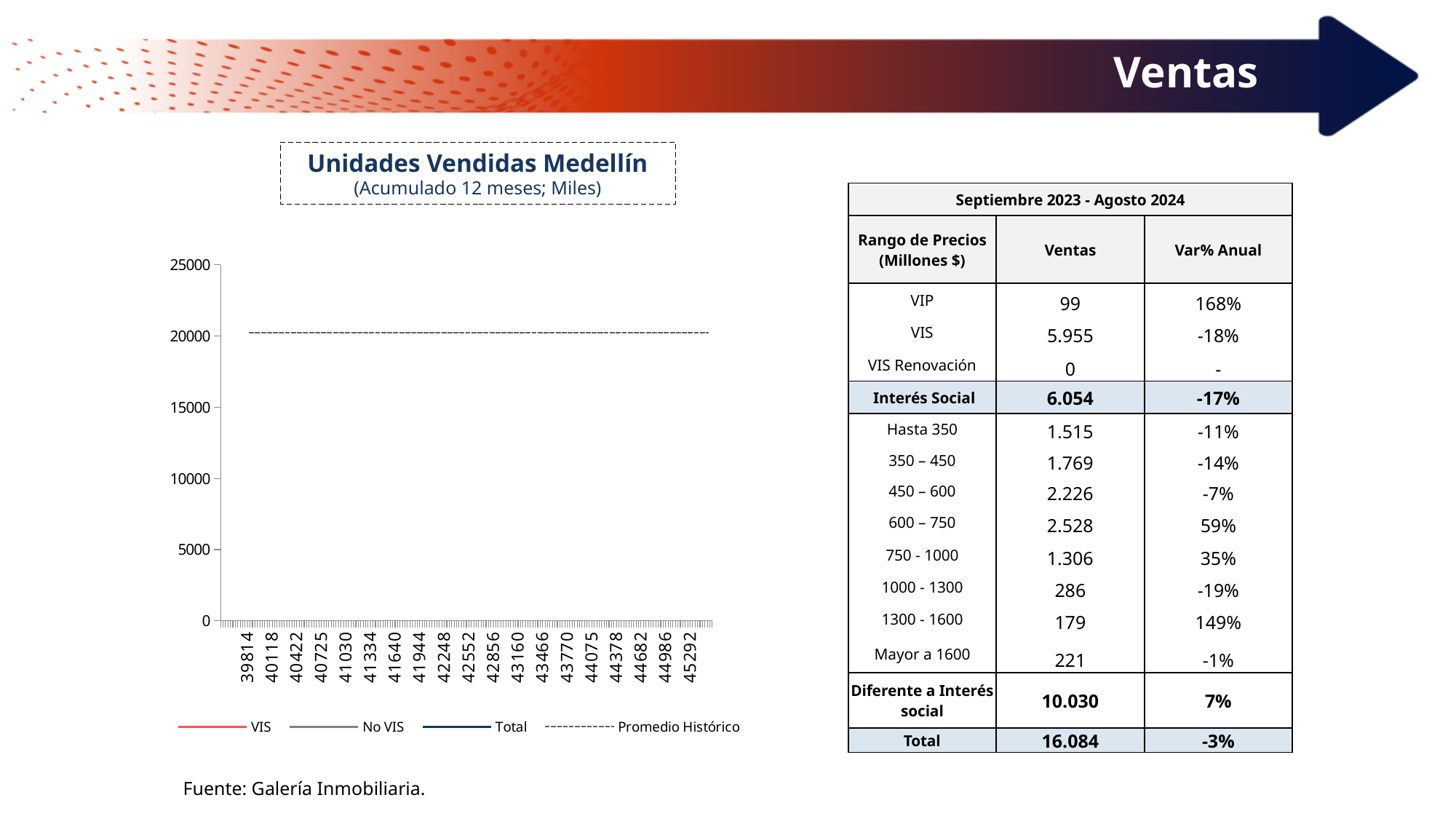
Which legend entry of the 'Unidades Vendidas Medellín' chart is drawn as a dashed line? Promedio Histórico What is the subtitle shown under the title 'Unidades Vendidas Medellín'? (Acumulado 12 meses; Miles) How many series does the legend of the 'Unidades Vendidas Medellín' chart list? 4 In the 'Unidades Vendidas Medellín' chart, is the Promedio Histórico line greater or less than 15000? greater In the 'Unidades Vendidas Medellín' chart, is the Promedio Histórico line greater or less than 25000? less In the 'Unidades Vendidas Medellín' chart, does the Promedio Histórico line rise, fall, or stay flat along the x axis? stay flat What kind of chart is shown under the title 'Unidades Vendidas Medellín'? line chart